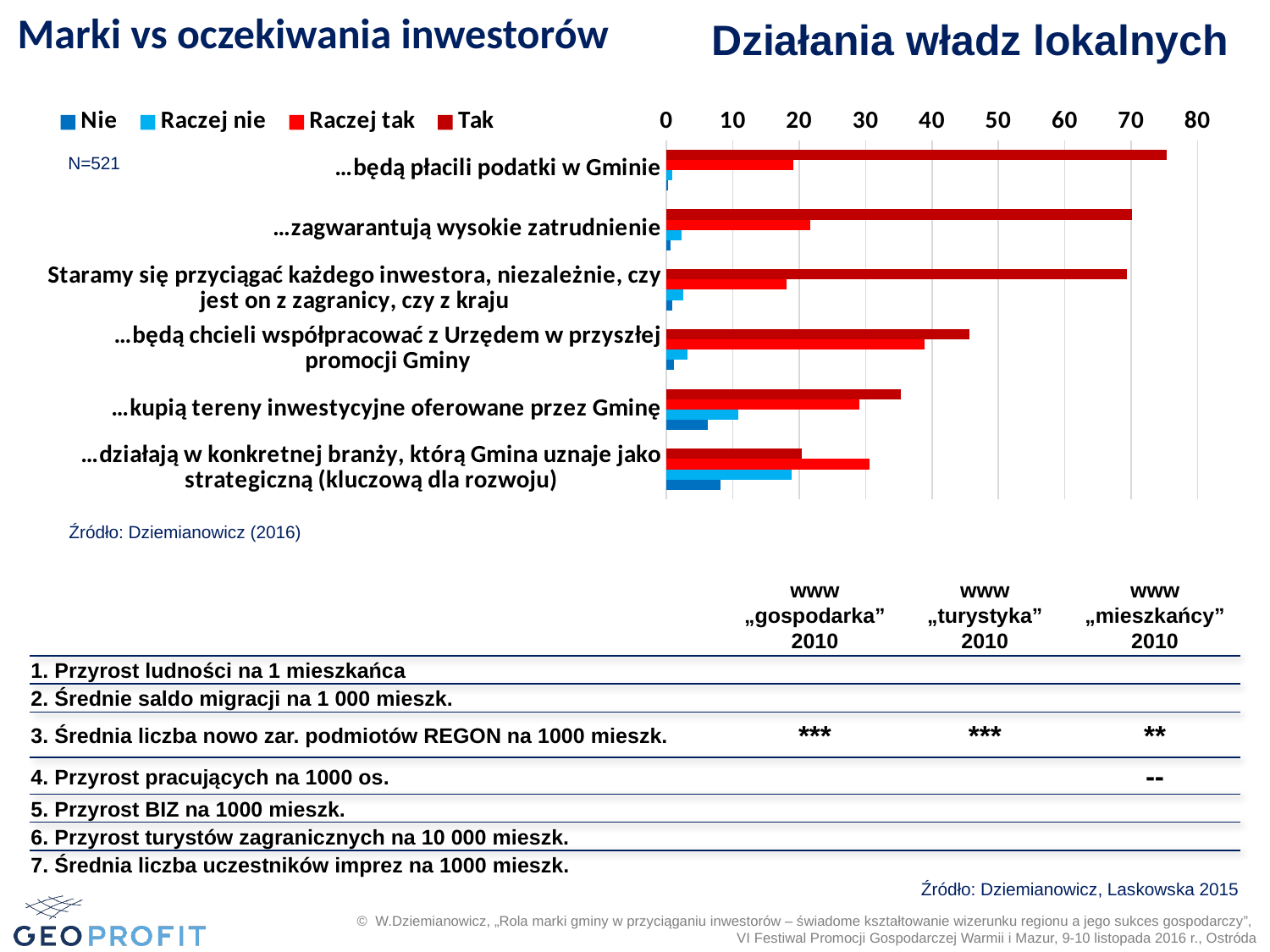
Is the 'Tak' value for '…kupią tereny inwestycyjne oferowane przez Gminę' greater or less than 40? less For '…działają w konkretnej branży, którą Gmina uznaje jako strategiczną', which is larger: the 'Tak' value or the 'Raczej tak' value? Raczej tak How many categories (statements) are plotted in the chart? 6 Which category has the larger 'Raczej nie' value: '…kupią tereny inwestycyjne oferowane przez Gminę' or '…będą płacili podatki w Gminie'? …kupią tereny inwestycyjne oferowane przez Gminę Which category has the highest value for the 'Tak' series? …będą płacili podatki w Gminie How many series does the chart legend list? 4 Is the 'Raczej tak' value for '…będą chcieli współpracować z Urzędem w przyszłej promocji Gminy' greater or less than 30? greater What sample size (N) is stated next to the chart? N=521 What kind of chart is shown on the slide? bar chart Do the 'Tak' values rise or fall going from the top category to the bottom category? fall Which category has the lowest value for the 'Tak' series? …działają w konkretnej branży, którą Gmina uznaje jako strategiczną (kluczową dla rozwoju) Is the 'Tak' value for '…będą płacili podatki w Gminie' greater or less than 70? greater